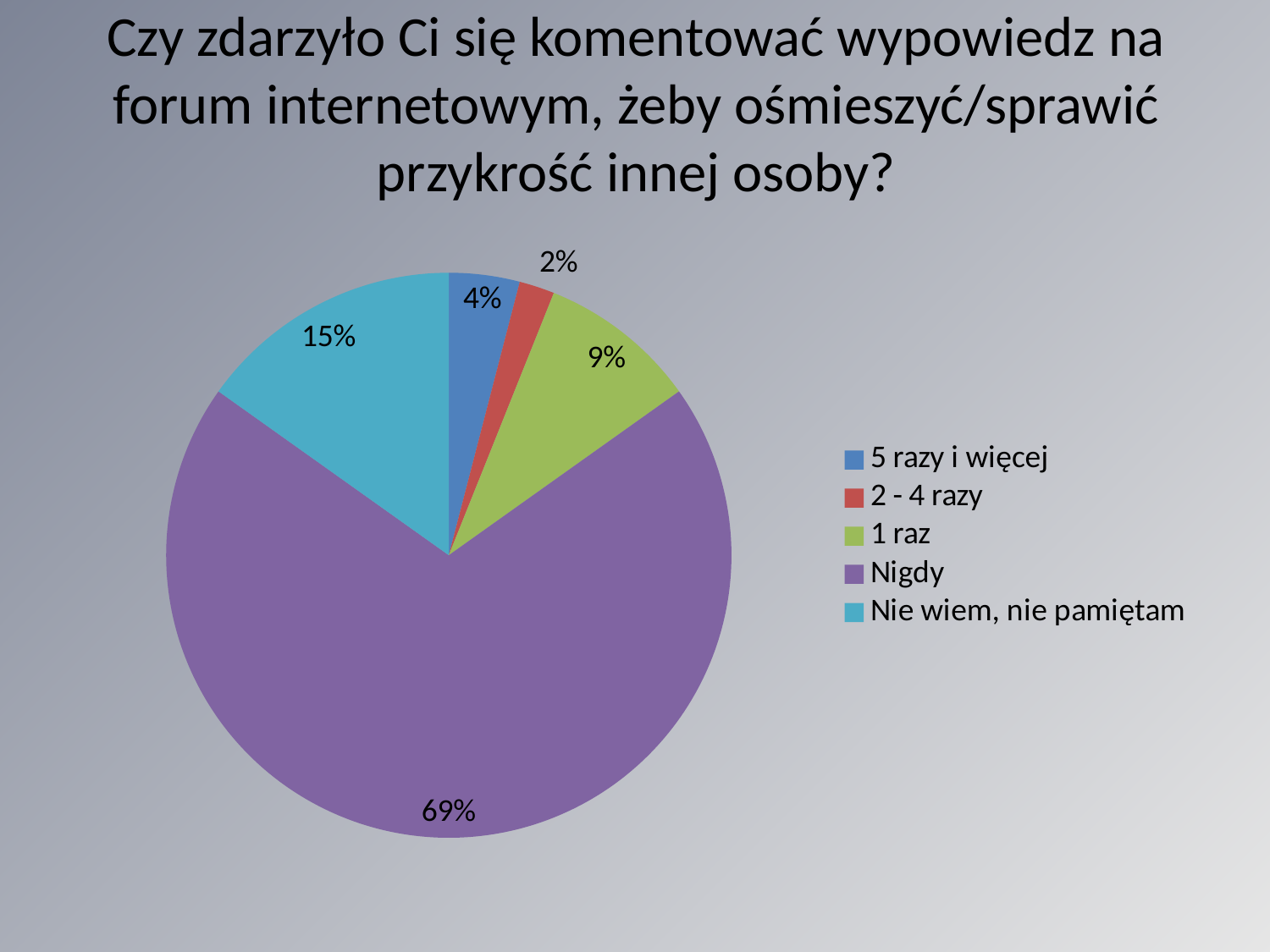
What percentage of respondents answered "Nie wiem, nie pamiętam"? 15% Which answer has the smallest share of the pie? 2 - 4 razy What colour is the slice for "Nigdy"? purple Which answer has the largest share of the pie? Nigdy What percentage of respondents answered "2 - 4 razy"? 2% What kind of chart is shown on the slide? pie chart What is the difference in percentage points between "Nigdy" and "Nie wiem, nie pamiętam"? 54 What percentage of respondents answered "1 raz"? 9% Which is larger: the share for "1 raz" or the share for "5 razy i więcej"? 1 raz What percentage of respondents answered "5 razy i więcej"? 4% What percentage of respondents answered "Nigdy"? 69% How many categories does the legend list? 5